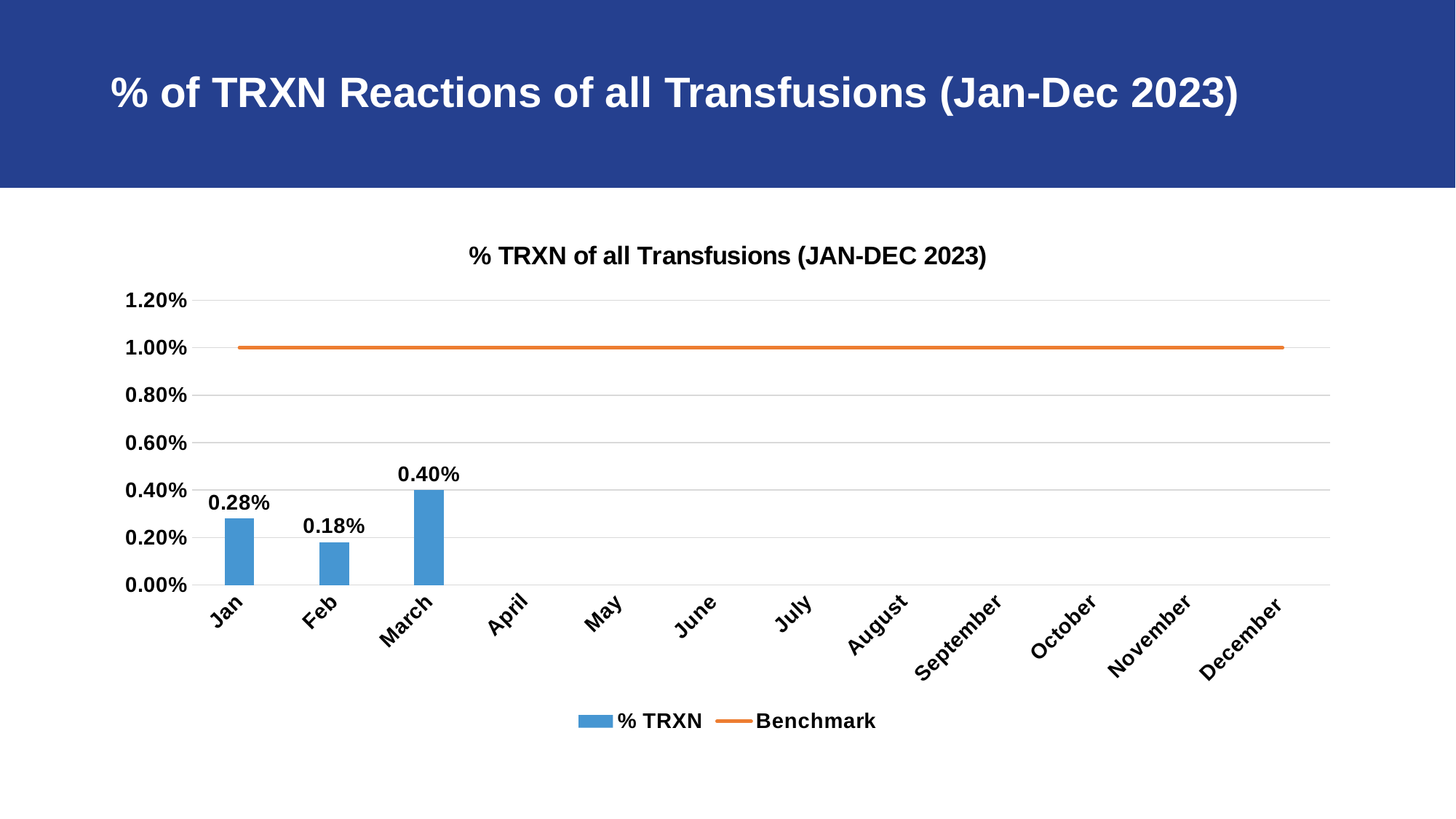
What is the % TRXN value for March? 0.40% What is the % TRXN value for Feb? 0.18% What kind of chart is used to show the % TRXN values? Bar chart Is the Benchmark line greater or less than 0.80%? greater Which month has the highest % TRXN bar? March Among the months with a plotted bar, which has the lowest % TRXN? Feb How many months are listed on the x axis? 12 What is the difference between the % TRXN values for March and Feb? 0.22% What is the title of the chart? % TRXN of all Transfusions (JAN-DEC 2023) What is the % TRXN value for Jan? 0.28% How many series does the legend list? 2 Which is larger, the % TRXN for Jan or for Feb? Jan